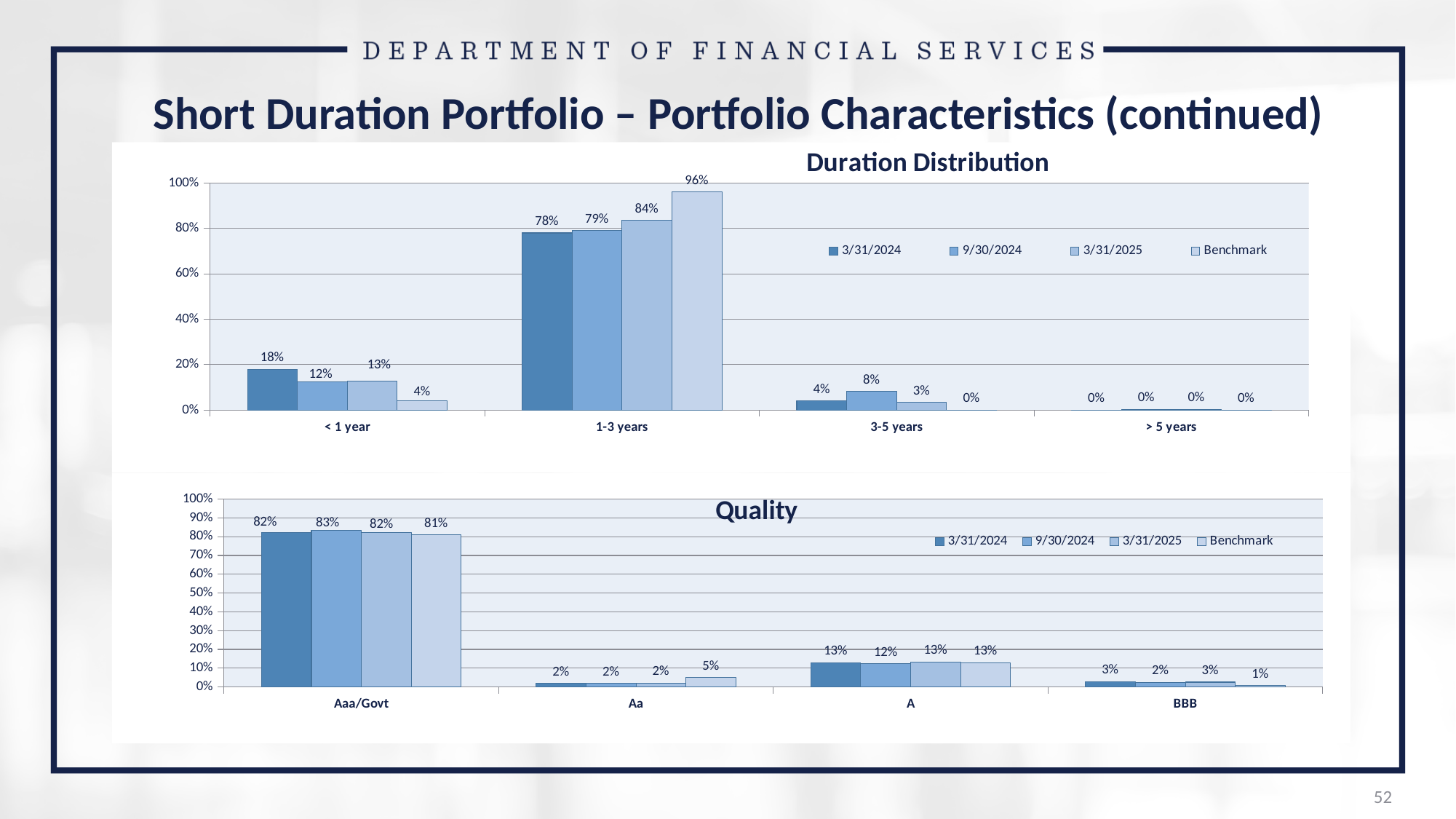
In the Quality chart, is the 3/31/2025 value for A larger or smaller than the 3/31/2025 value for BBB? larger In the Duration Distribution chart, what is the Benchmark value for 1-3 years? 96% In the Quality chart, which rating category has the lowest Benchmark value? BBB In the Duration Distribution chart, how many duration categories are shown on the x axis? 4 What kind of chart is the Quality chart? bar chart In the Duration Distribution chart, what is the 9/30/2024 value for 3-5 years? 8% In the Duration Distribution chart, how many series does the legend list? 4 In the Duration Distribution chart, what is the 3/31/2024 value for < 1 year? 18% In the Duration Distribution chart, which duration bucket has the highest 3/31/2025 value? 1-3 years In the Duration Distribution chart, what is the difference between the Benchmark and 3/31/2024 values for 1-3 years? 18% In the Quality chart, what is the Benchmark value for Aa? 5% In the Quality chart, what is the 9/30/2024 value for Aaa/Govt? 83%